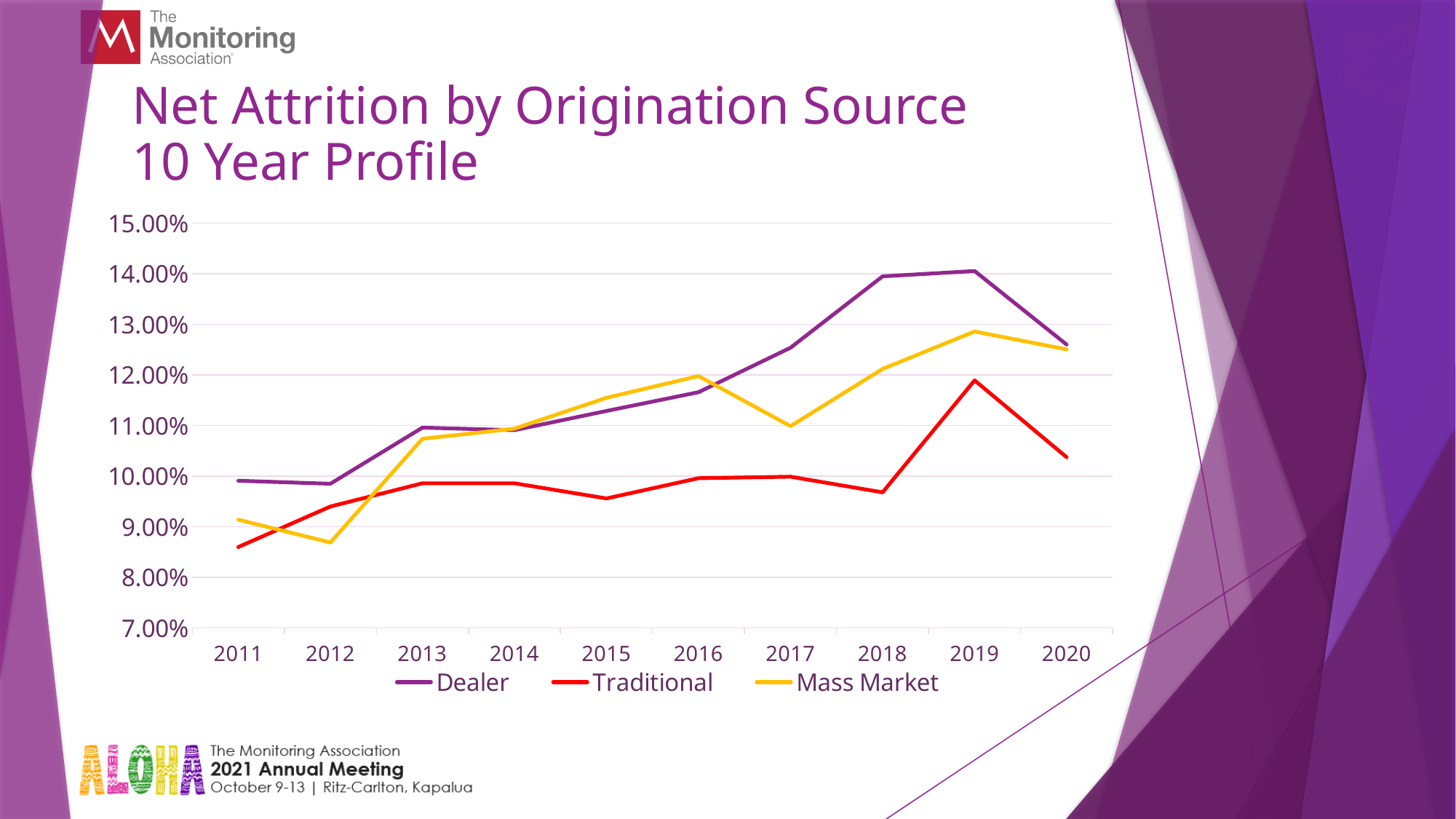
Is the value for Traditional in 2011 greater or less than 9.00%? less Which series has the lowest value in 2020? Traditional In 2018, which is larger: the Dealer value or the Traditional value? Dealer How many series does the legend list? 3 Which series has the highest value in 2019? Dealer Is the value for Dealer in 2018 greater or less than 13.00%? greater How many years are shown along the x axis? 10 Is the value for Mass Market in 2019 greater or less than 12.00%? greater What kind of chart is shown on the slide? line chart Does the Dealer series generally rise or fall from 2011 to 2019? rise In which year does the Traditional series reach its highest value? 2019